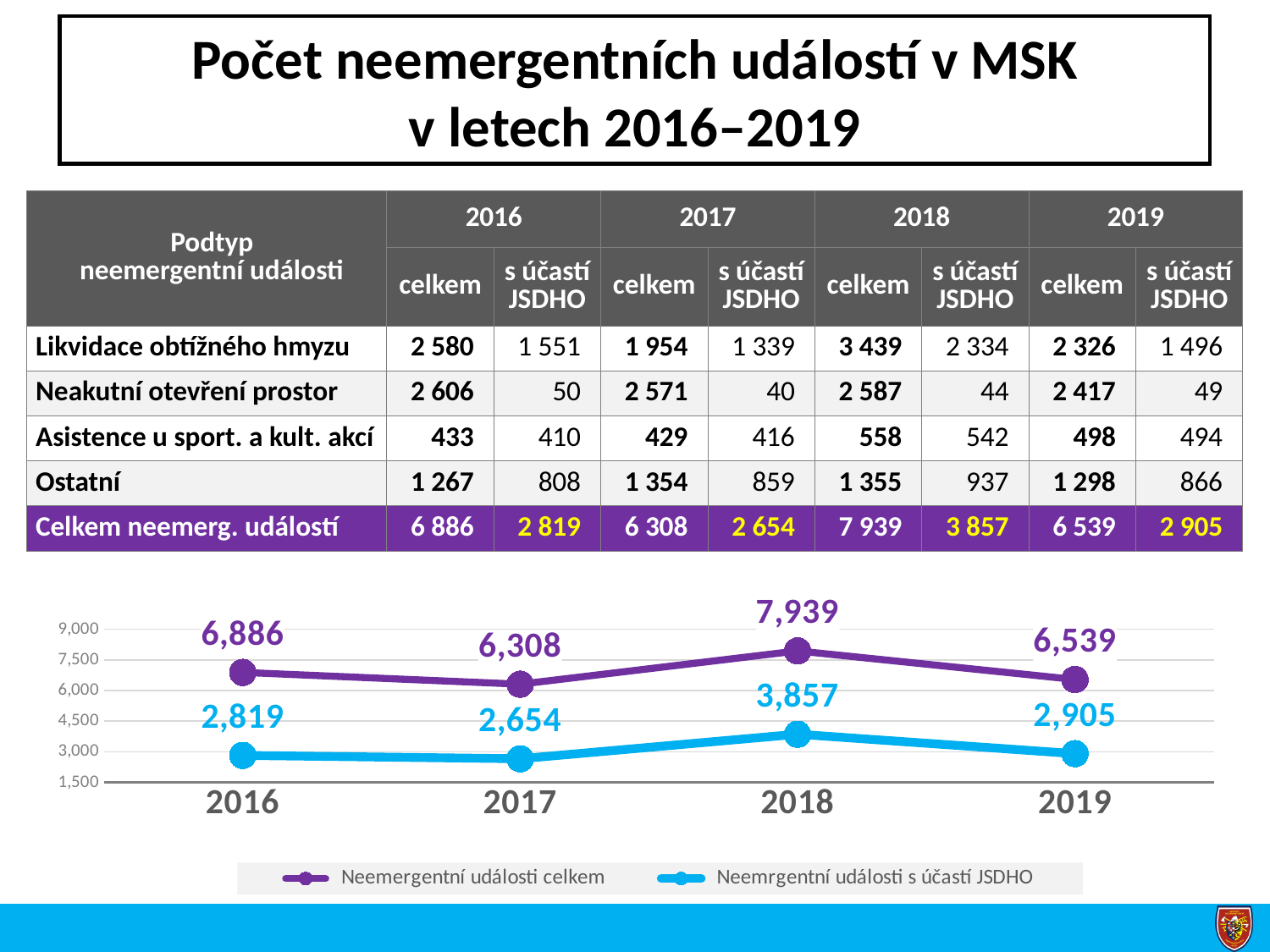
What is the difference between 'Neemrgentní události s účastí JSDHO' in 2018 and 2016? 1,038 How many series does the chart legend list? 2 In which year is 'Neemergentní události celkem' highest? 2018 What kind of chart is shown at the bottom of the slide? line chart Does 'Neemergentní události celkem' rise or fall from 2018 to 2019? fall What is the value of 'Neemergentní události celkem' in 2018? 7,939 What is the value of 'Neemrgentní události s účastí JSDHO' in 2017? 2,654 What colour is the line for 'Neemrgentní události s účastí JSDHO'? blue Which is larger: 'Neemergentní události celkem' in 2016 or in 2017? 2016 In which year is 'Neemrgentní události s účastí JSDHO' lowest? 2017 How many years are plotted on the x axis of the chart? 4 What is the difference between 'Neemergentní události celkem' and 'Neemrgentní události s účastí JSDHO' in 2019? 3,634